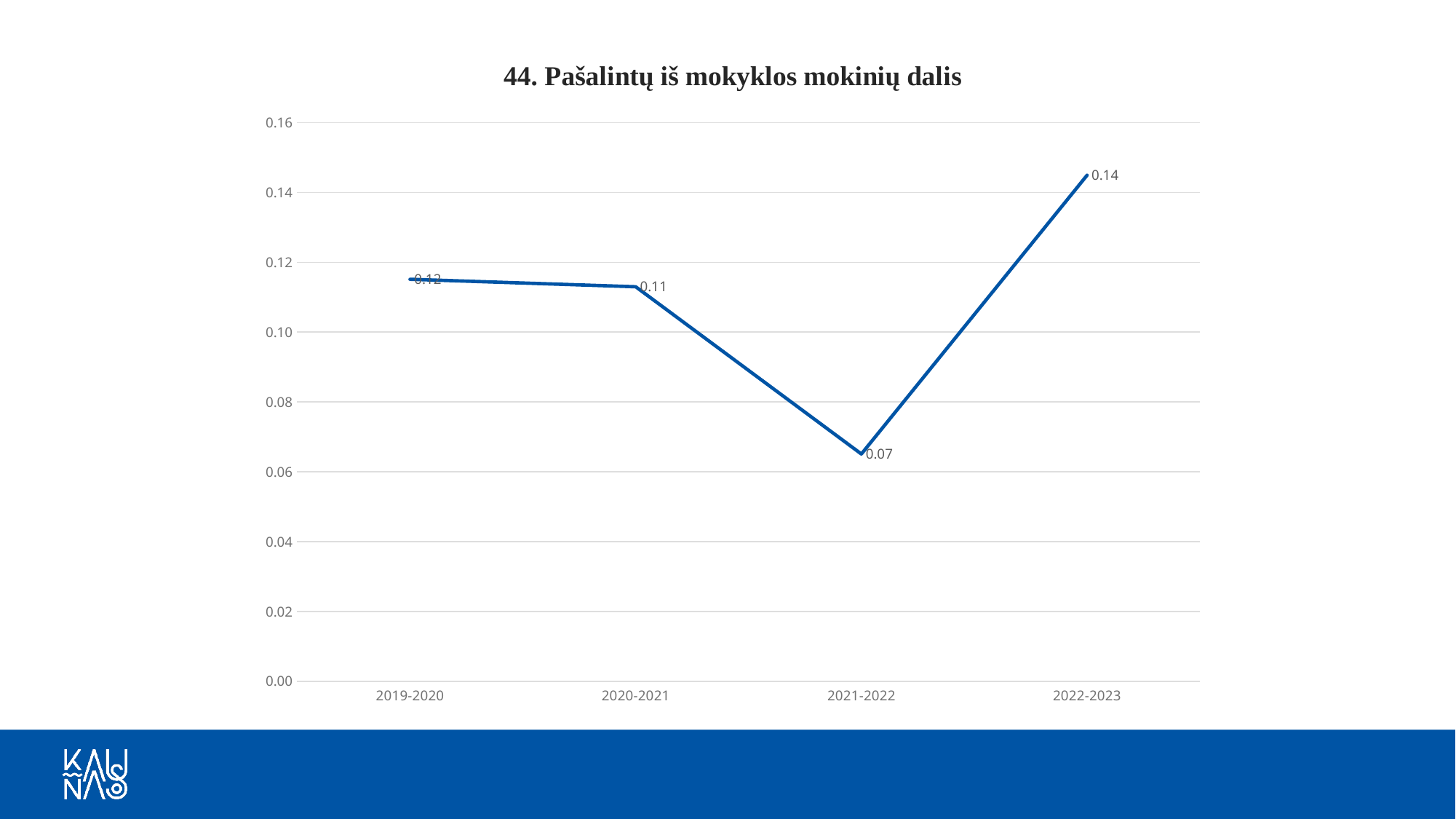
What is the value for 2020-2021? 0.11 What is the difference between the values for 2022-2023 and 2021-2022? 0.07 What kind of chart is shown on the slide? line chart Which school year has the lowest value? 2021-2022 What is the title of the chart? 44. Pašalintų iš mokyklos mokinių dalis Is the value for 2021-2022 greater or less than 0.08? less Which school year has the highest value? 2022-2023 Which is larger, the value for 2019-2020 or the value for 2021-2022? 2019-2020 What is the value for 2019-2020? 0.12 What is the value for 2022-2023? 0.14 What is the value for 2021-2022? 0.07 How many school years are plotted on the x axis? 4